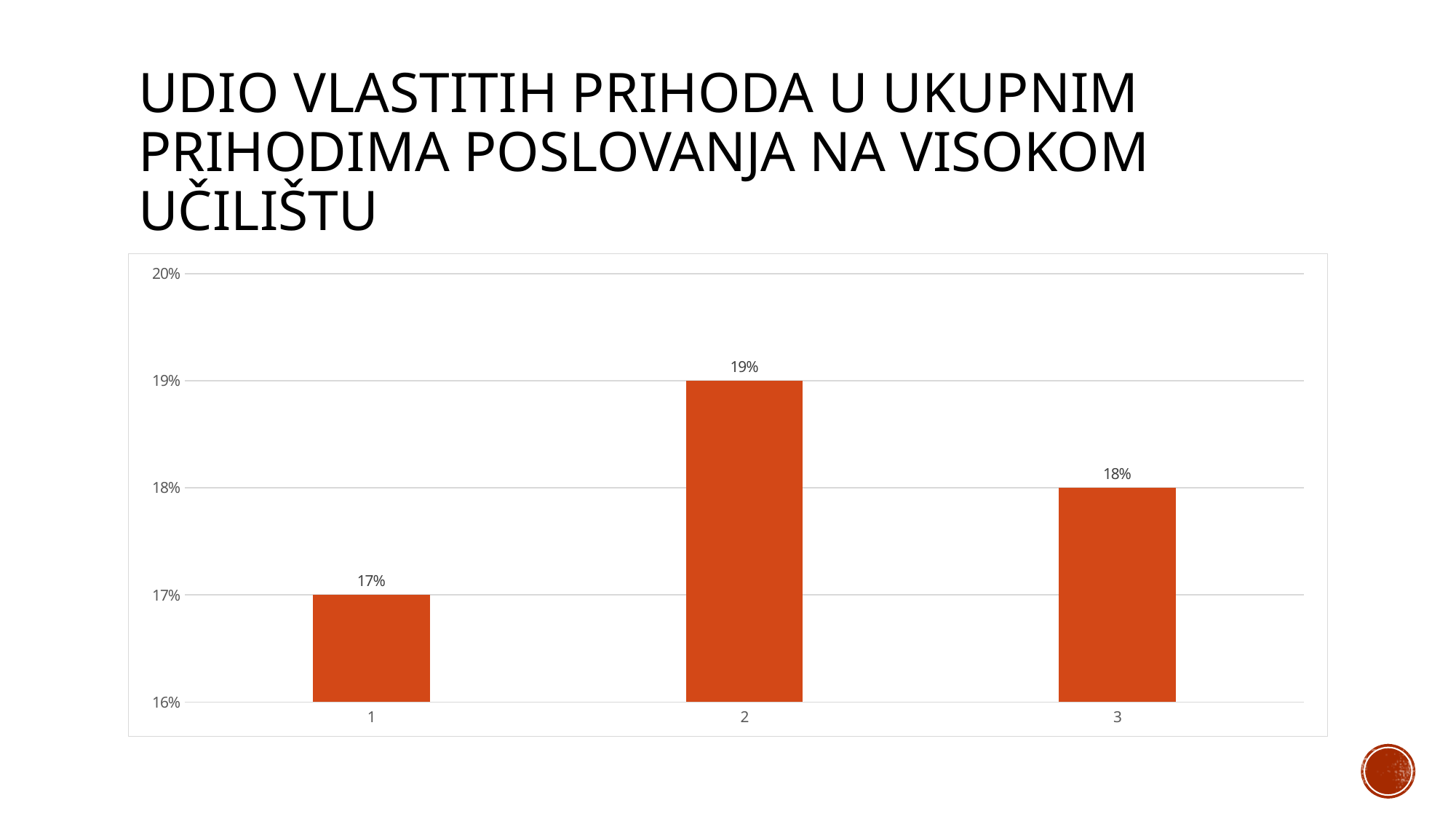
What is the difference between the values for category 2 and category 1? 2% Is the value for category 2 greater or less than 18%? greater What kind of chart is shown on the slide? bar chart How many bars are shown in the chart? 3 What is the value for category 1? 17% What is the value for category 3? 18% What is the difference between the values for category 3 and category 1? 1% What is the value for category 2? 19% What is the title of the slide? Udio vlastitih prihoda u ukupnim prihodima poslovanja na visokom učilištu Which is larger, the value for category 2 or category 3? 2 Which category has the highest value? 2 Which category has the lowest value? 1